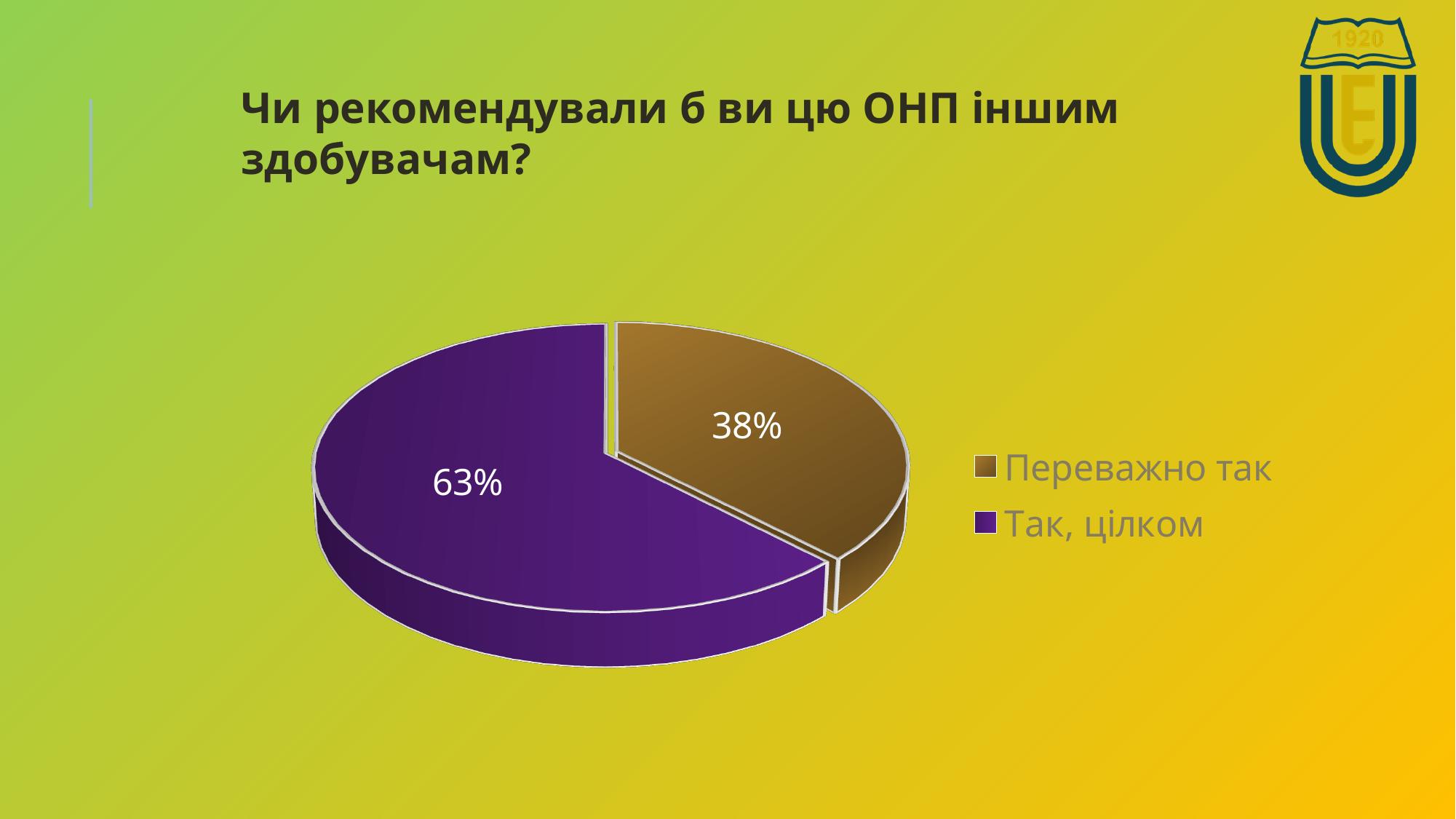
What kind of chart is shown on the slide? Pie chart What is the title of the chart on the slide? Чи рекомендували б ви цю ОНП іншим здобувачам? Which category has the largest slice of the pie? Так, цілком How many categories are shown in the pie chart? 2 What share of the pie does "Переважно так" take? 38% What share of the pie does "Так, цілком" take? 63% Which category has the smallest slice of the pie? Переважно так What colour is the slice for "Так, цілком"? Purple Which is larger: the slice for "Так, цілком" or the slice for "Переважно так"? Так, цілком What is the difference in percentage points between "Так, цілком" and "Переважно так"? 25 How many entries does the legend list? 2